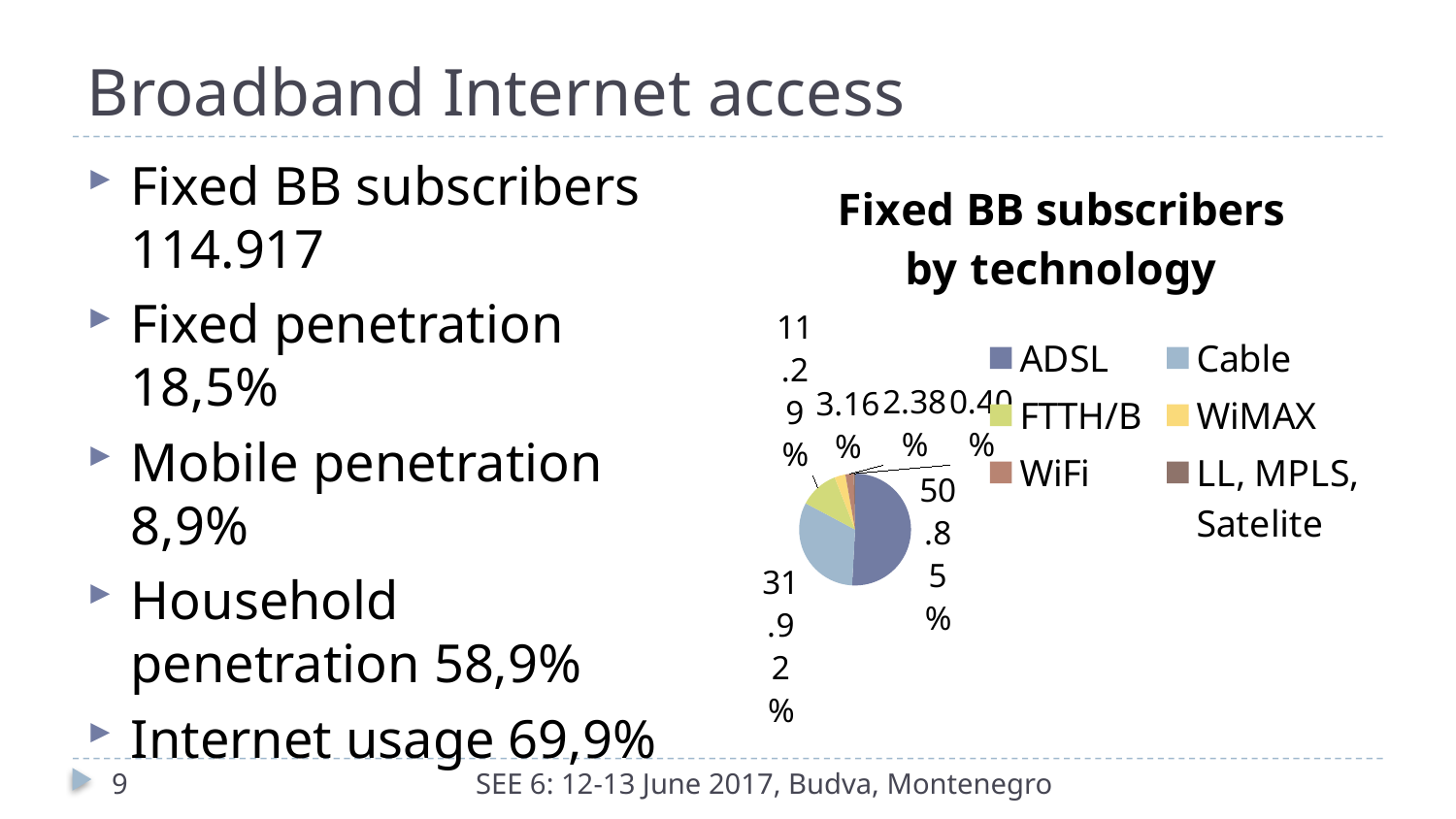
What share of fixed BB subscribers uses ADSL? 50.85% Which legend entry is shown in dark blue? ADSL Which technology has the smallest share of fixed BB subscribers? LL, MPLS, Satelite What is the value shown for FTTH/B in the pie chart? 11.29% What is the smallest percentage value printed on the pie chart? 0.40% What kind of chart is shown on the slide? pie chart Which has a larger share, Cable or FTTH/B? Cable What is the title of the chart? Fixed BB subscribers by technology Which technology has the largest share of fixed BB subscribers? ADSL How many technology categories does the legend of the pie chart list? 6 What is the difference between the ADSL share and the Cable share? 18.93% What is the value shown for Cable in the pie chart? 31.92%